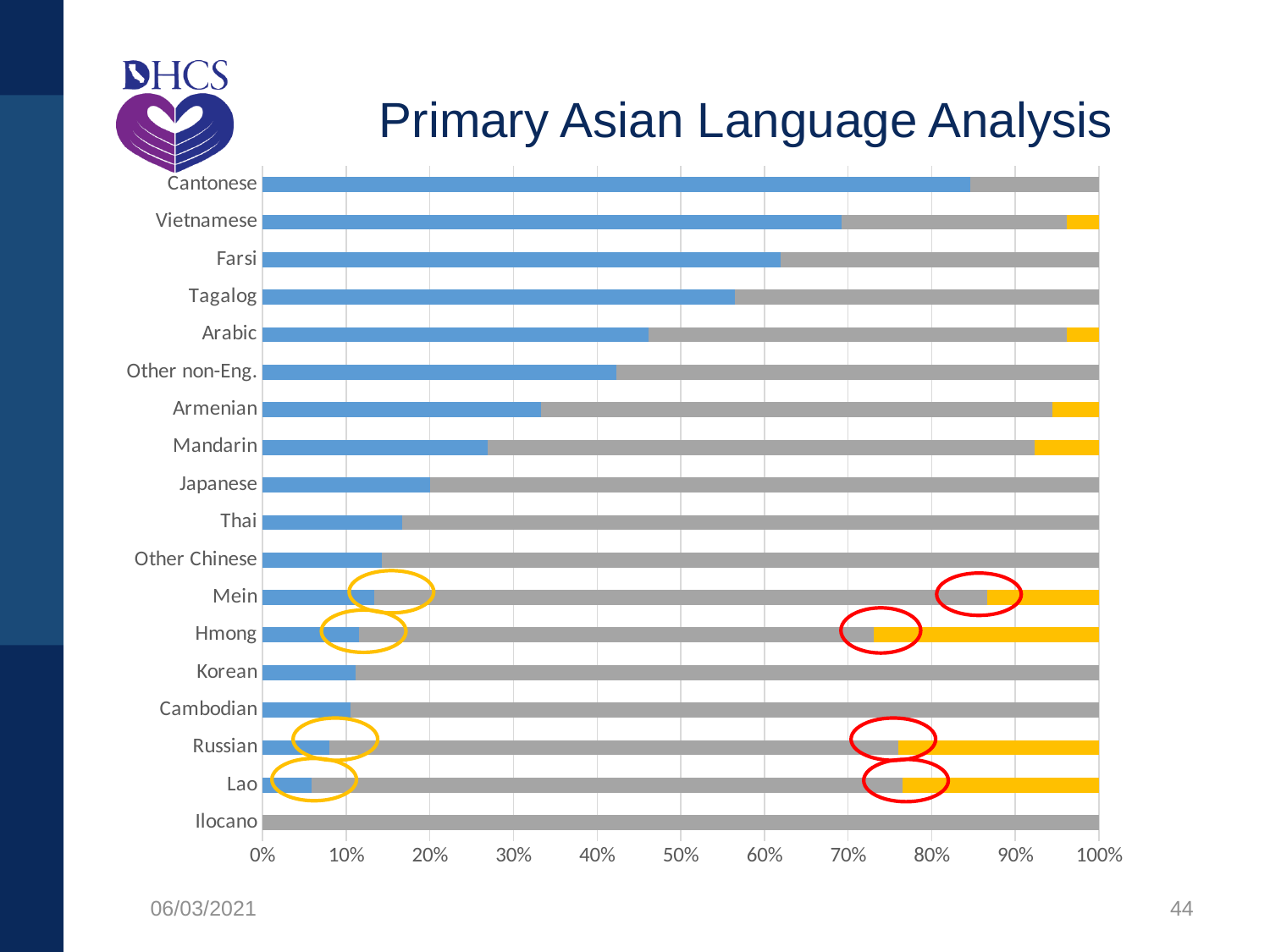
Is the blue segment for Japanese greater or less than 30%? less What is the title of the chart? Primary Asian Language Analysis Do the blue segments get longer or shorter going from the top of the chart to the bottom? shorter Which language has no blue segment at all? Ilocano What type of chart is shown on the slide? bar chart Which has a longer yellow segment, Hmong or Mein? Hmong Is the blue segment for Arabic greater or less than 50%? less Is the blue segment for Tagalog greater or less than 50%? greater How many languages are listed on the chart? 18 Which language has the longest blue segment? Cantonese Which has a longer blue segment, Vietnamese or Farsi? Vietnamese